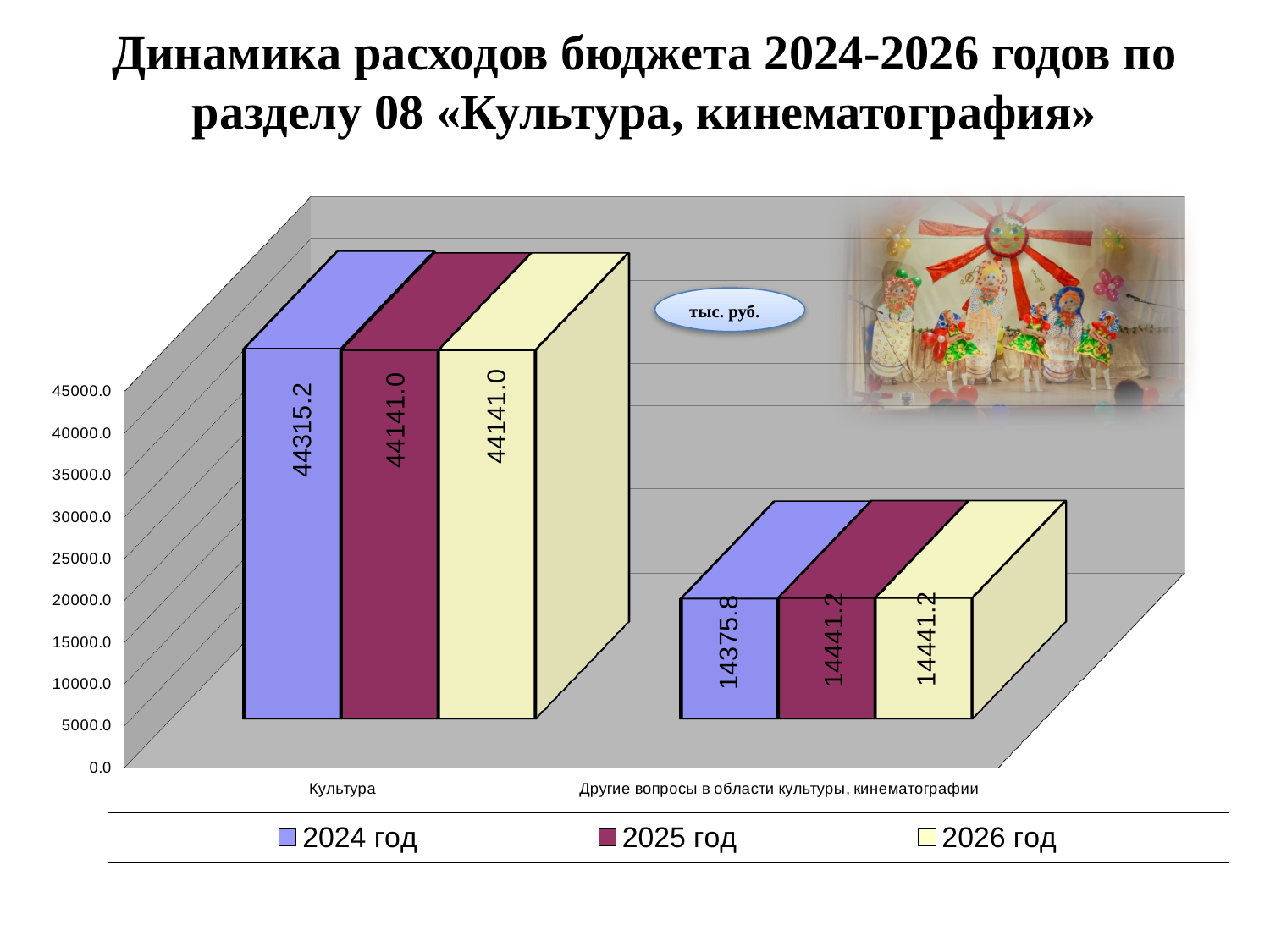
What is the difference between the 2025 год and 2024 год values for Другие вопросы в области культуры, кинематографии? 65.4 Which category has the highest value in 2024 год? Культура How many series does the legend list? 3 Which category has the lowest value in 2026 год? Другие вопросы в области культуры, кинематографии What is the value for Другие вопросы в области культуры, кинематографии in 2025 год? 14441.2 What is the difference between the 2024 год and 2025 год values for Культура? 174.2 What unit is indicated in the callout on the chart? тыс. руб. What kind of chart is shown on the slide? Bar chart Which is larger: the 2024 год value for Культура or the 2024 год value for Другие вопросы в области культуры, кинематографии? Культура What is the value for Культура in 2026 год? 44141.0 What is the value for Культура in 2024 год? 44315.2 What is the value for Другие вопросы в области культуры, кинематографии in 2024 год? 14375.8